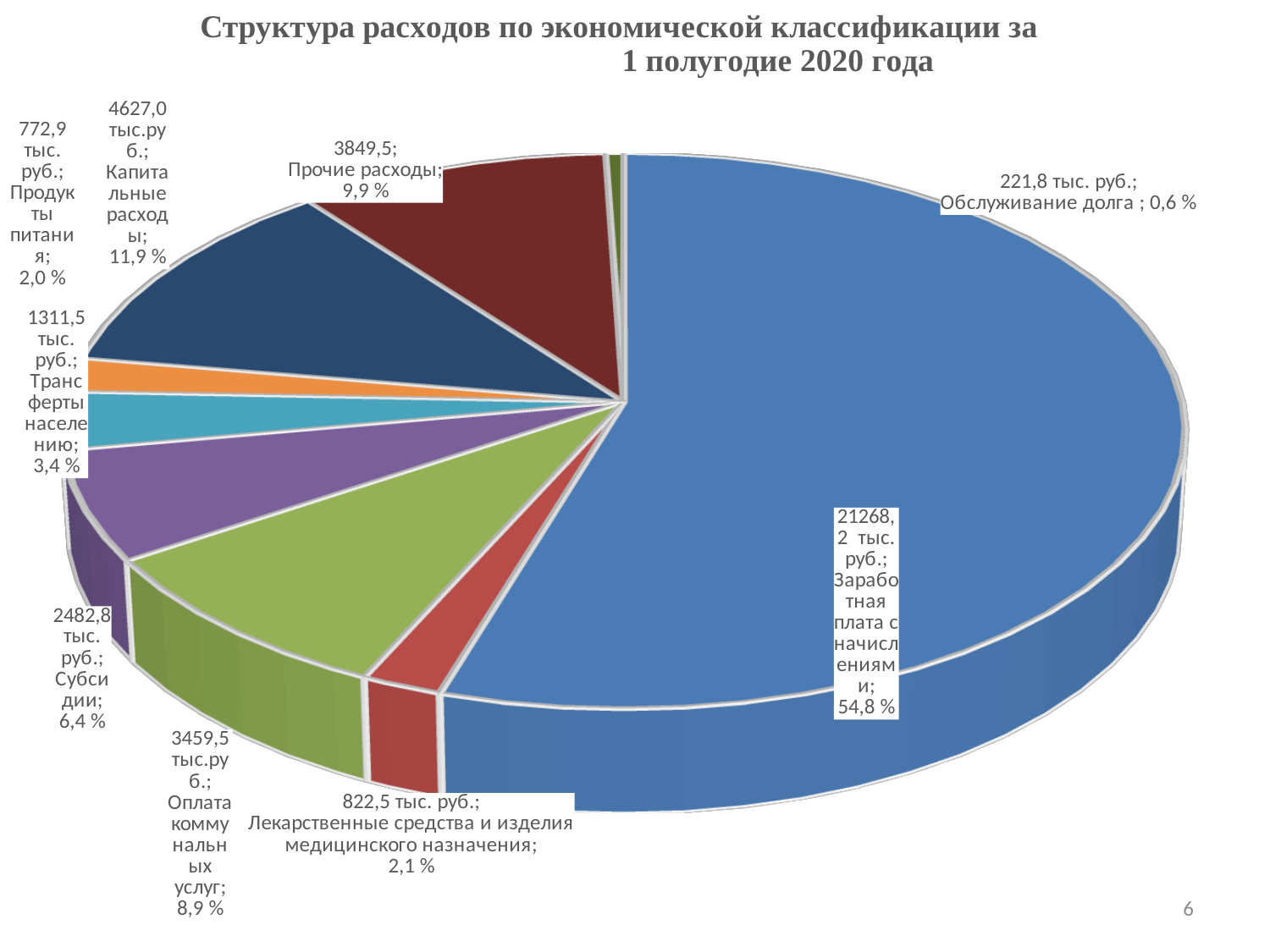
What is the difference between the share of Капитальные расходы and the share of Оплата коммунальных услуг? 3,0 % What is the title of the chart? Структура расходов по экономической классификации за 1 полугодие 2020 года Which category has the largest slice of the pie? Заработная плата с начислениями What type of chart is shown on the slide? Pie chart Which is larger, the value for Субсидии or the value for Трансферты населению? Субсидии Which category has the smallest slice of the pie? Обслуживание долга How many slices does the pie chart have? 9 What is the value for Обслуживание долга? 221,8 тыс. руб. What share of the pie does Лекарственные средства и изделия медицинского назначения take? 2,1 % What is the value for Капитальные расходы? 4627,0 тыс.руб. What share of the pie does Прочие расходы take? 9,9 % What share of the pie does Заработная плата с начислениями take? 54,8 %